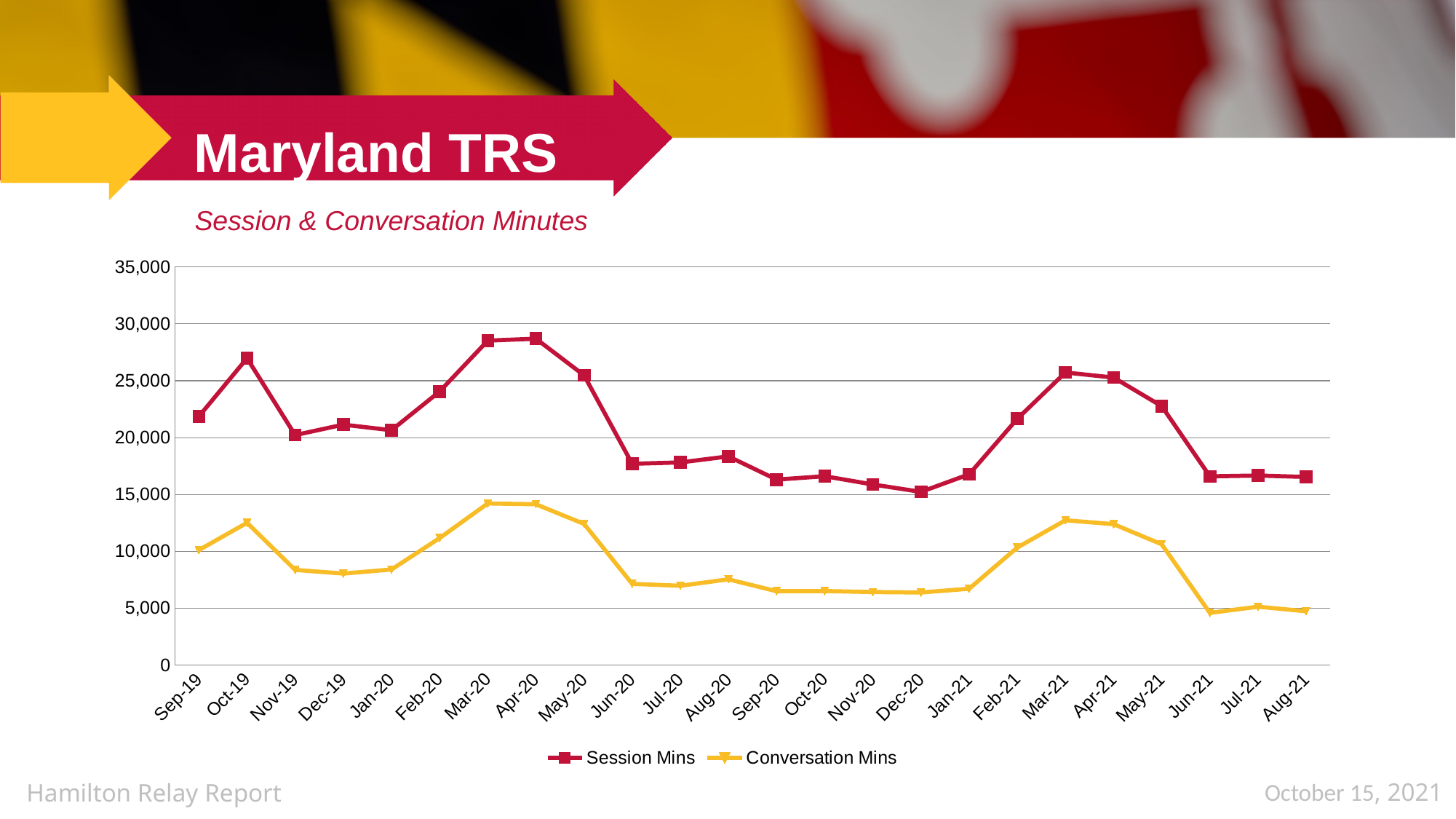
What kind of chart is shown on the slide? Line chart Is the value for Conversation Mins in Oct-19 greater or less than 10,000? greater Which month has the lowest value for Session Mins? Dec-20 How many series does the legend list? 2 Which is larger for Session Mins: Oct-19 or Nov-19? Oct-19 What is the subtitle of the chart shown on the slide? Session & Conversation Minutes Which is larger for Conversation Mins: Jan-21 or Feb-21? Feb-21 Is the value for Session Mins in Jun-20 greater or less than 20,000? less Do the Session Mins values rise or fall from Apr-20 to Jun-20? fall How many months are plotted along the x axis? 24 Is the value for Session Mins in Oct-19 greater or less than 25,000? greater